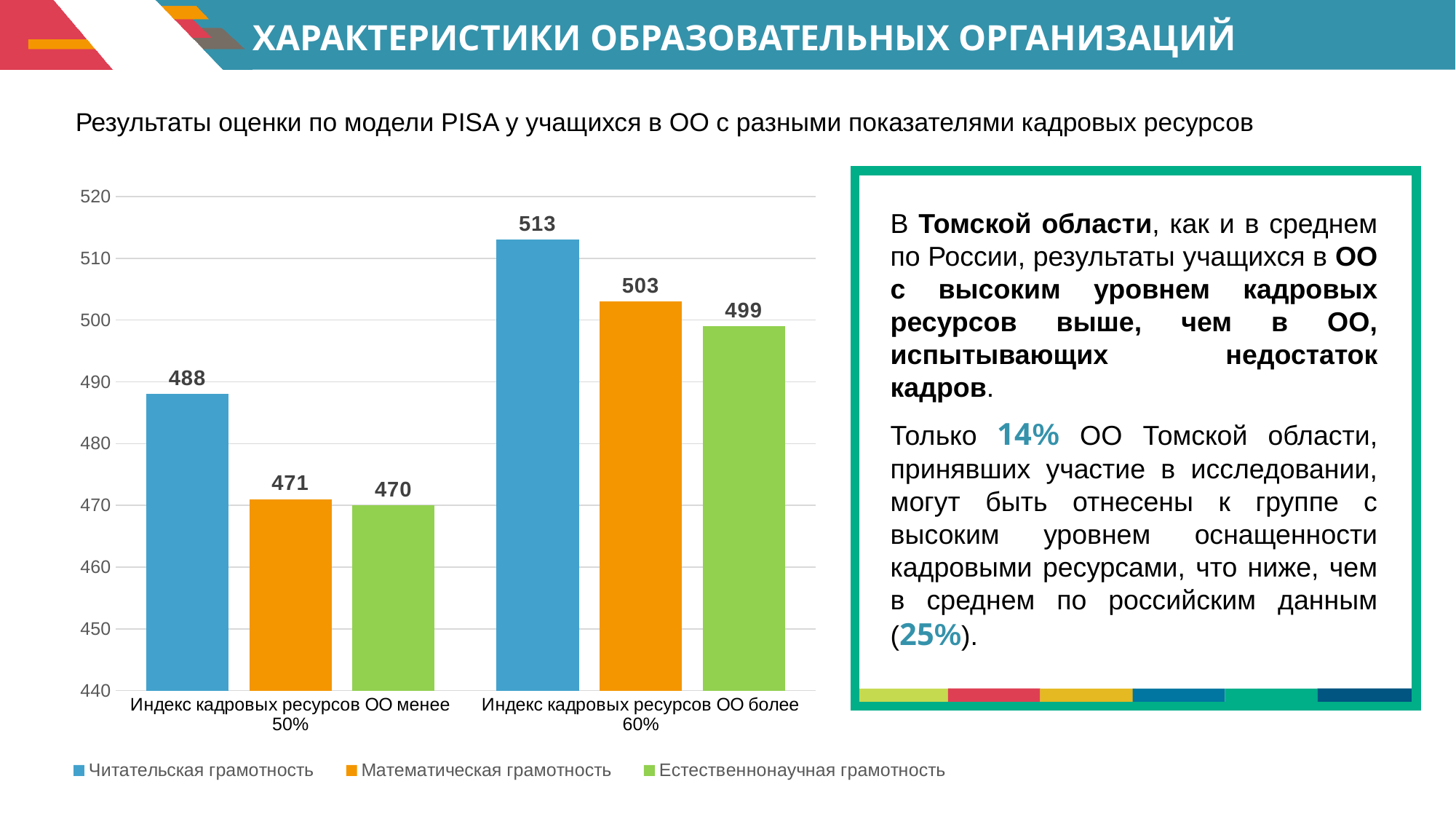
How many categories are shown on the x axis of the chart? 2 What is the value for Читательская грамотность in the category 'Индекс кадровых ресурсов ОО менее 50%'? 488 Which series has the highest value in the category 'Индекс кадровых ресурсов ОО более 60%'? Читательская грамотность What is the value for Математическая грамотность in the category 'Индекс кадровых ресурсов ОО более 60%'? 503 How many series does the legend list? 3 What kind of chart is shown on the slide? Bar chart Is the value for Математическая грамотность in 'Индекс кадровых ресурсов ОО более 60%' greater or less than 500? greater Which is larger: Естественнонаучная грамотность for 'Индекс кадровых ресурсов ОО более 60%' or Математическая грамотность for 'Индекс кадровых ресурсов ОО менее 50%'? Естественнонаучная грамотность for 'Индекс кадровых ресурсов ОО более 60%' What is the value for Естественнонаучная грамотность in the category 'Индекс кадровых ресурсов ОО менее 50%'? 470 What is the difference between the Математическая грамотность values for the two categories? 32 Which series has the lowest value in the category 'Индекс кадровых ресурсов ОО менее 50%'? Естественнонаучная грамотность What is the difference between the Читательская грамотность values for 'Индекс кадровых ресурсов ОО более 60%' and 'Индекс кадровых ресурсов ОО менее 50%'? 25